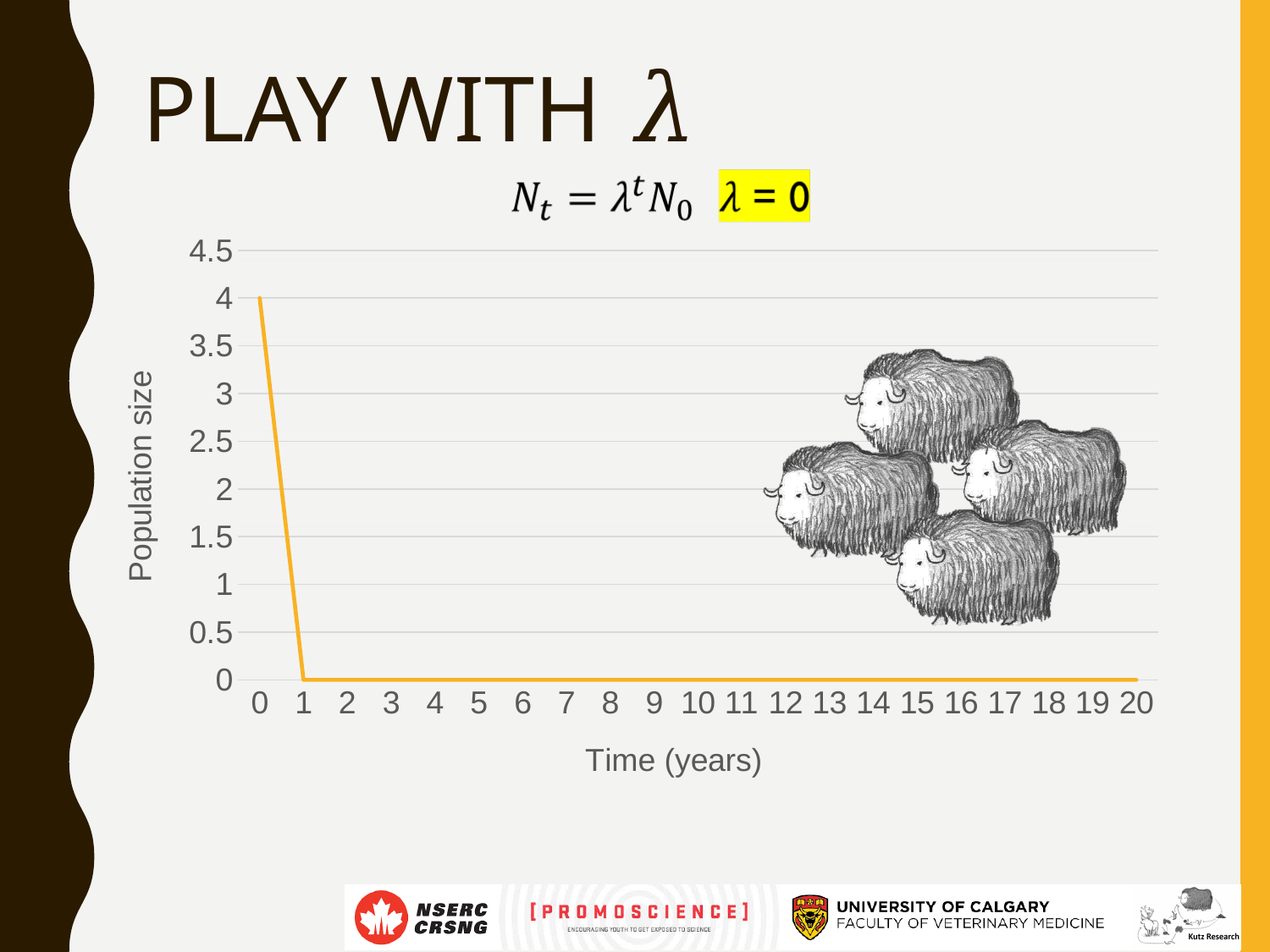
At which time (in years) is the population size highest? 0 What kind of chart is shown on the slide? line chart What is the label of the x axis? Time (years) Which is larger, the population size at time 0 or at time 5? time 0 What is the population size at time 0 years? 4 What is the population size at time 1 year? 0 What is the population size at time 20 years? 0 What is the difference between the population size at time 0 and at time 1? 4 What is the label of the y axis? Population size What is the population size at time 10 years? 0 Does the population size rise or fall between time 0 and time 1? fall What is the highest value shown on the y axis? 4.5